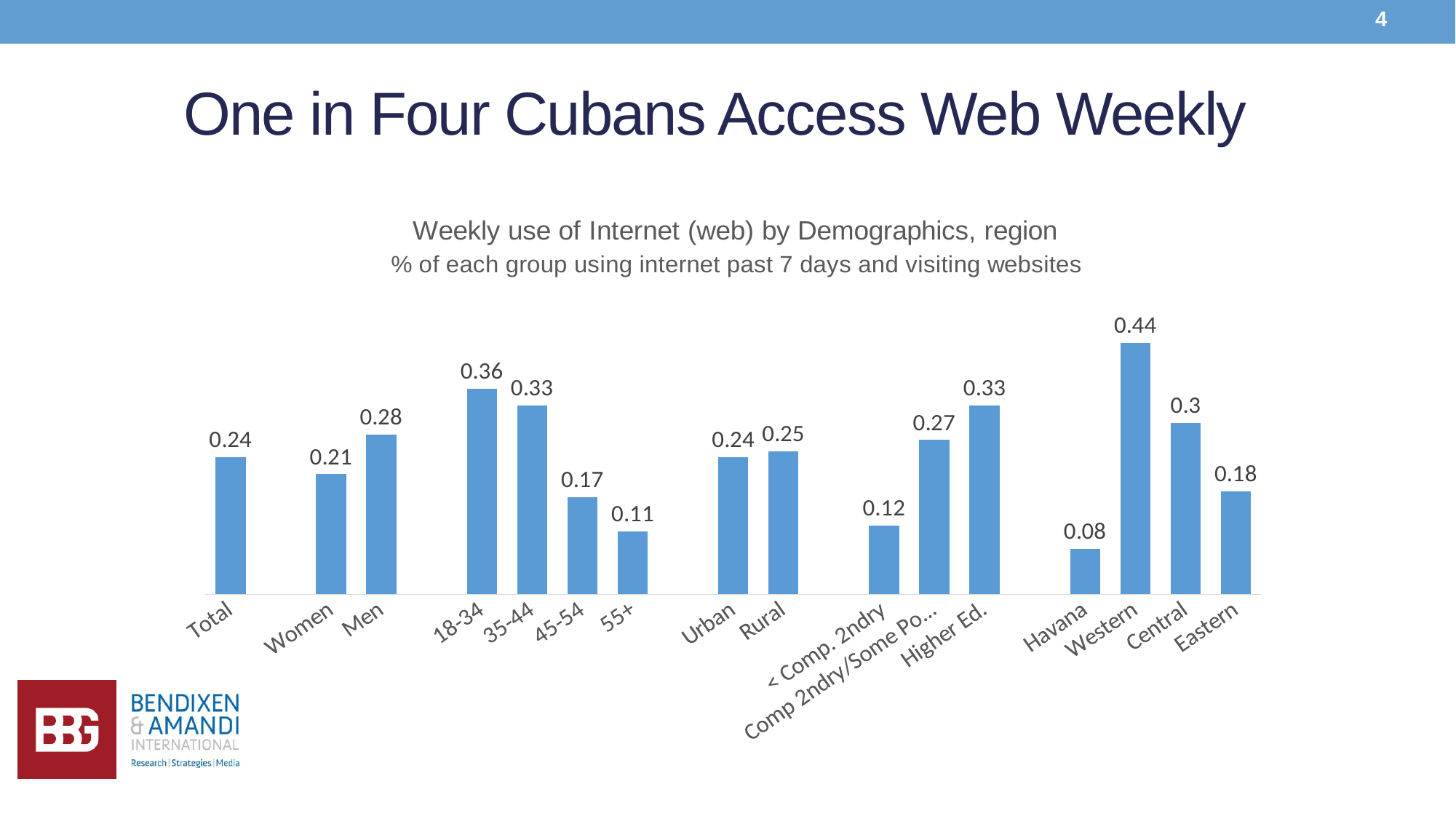
What is the difference between the values for Men and Women? 0.07 Which has a larger value, Urban or Rural? Rural How many bars are plotted in the chart? 16 What is the value for Higher Ed.? 0.33 Which category has the lowest value? Havana What is the value for the 18-34 age group? 0.36 What is the value for Havana? 0.08 What is the value for Total? 0.24 Which category has the highest value? Western What is the difference between the values for Western and Central? 0.14 Which has a larger value, 45-54 or 55+? 45-54 What kind of chart is shown on the slide? Bar chart